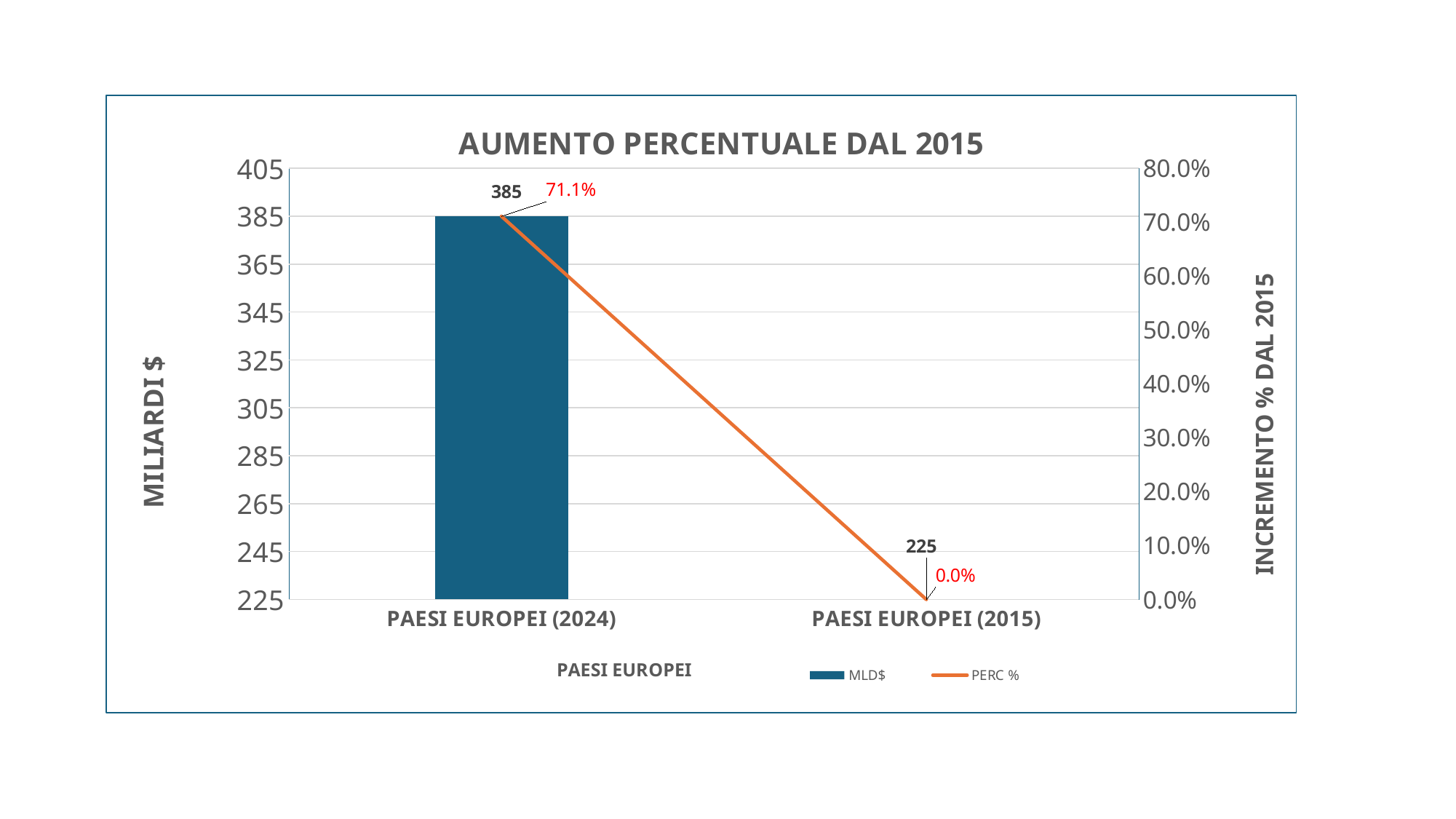
What is the difference in MLD$ between PAESI EUROPEI (2024) and PAESI EUROPEI (2015)? 160 How many categories are shown on the x axis? 2 Is the MLD$ value for PAESI EUROPEI (2024) greater or less than 365? greater What is the MLD$ value for PAESI EUROPEI (2024)? 385 How many series does the legend list? 2 What is the PERC % value for PAESI EUROPEI (2024)? 71.1% What is the MLD$ value for PAESI EUROPEI (2015)? 225 Which category has the higher MLD$ value? PAESI EUROPEI (2024) Which category has the lower PERC % value? PAESI EUROPEI (2015) What is the title of the chart? AUMENTO PERCENTUALE DAL 2015 What is the label of the right-hand vertical axis? INCREMENTO % DAL 2015 What is the PERC % value for PAESI EUROPEI (2015)? 0.0%